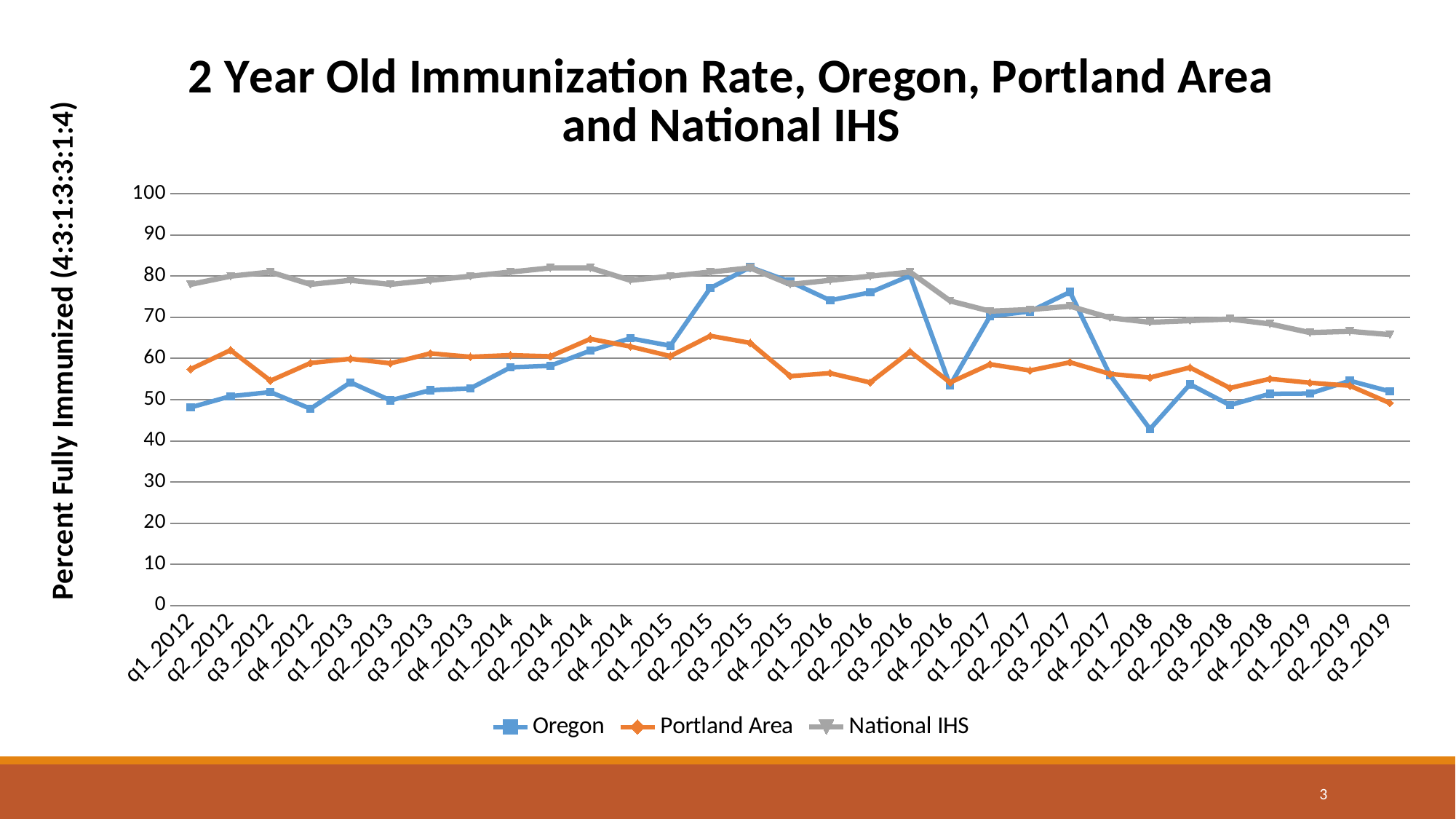
How many series does the legend list? 3 Is the value for Oregon at q2_2018 greater or less than 50? greater Does the National IHS series rise or fall from q3_2016 to q3_2019? fall Is the value for Portland Area at q3_2014 greater or less than 60? greater In which quarter does the Oregon series reach its lowest value? q1_2018 Is the value for National IHS at q3_2019 greater or less than 70? less What is the label on the vertical axis? Percent Fully Immunized (4:3:1:3:3:1:4) At q2_2018, which is higher, Oregon or National IHS? National IHS At q1_2012, which is higher, Oregon or Portland Area? Portland Area How many quarters are plotted along the x axis? 31 What kind of chart is shown on the slide? line chart